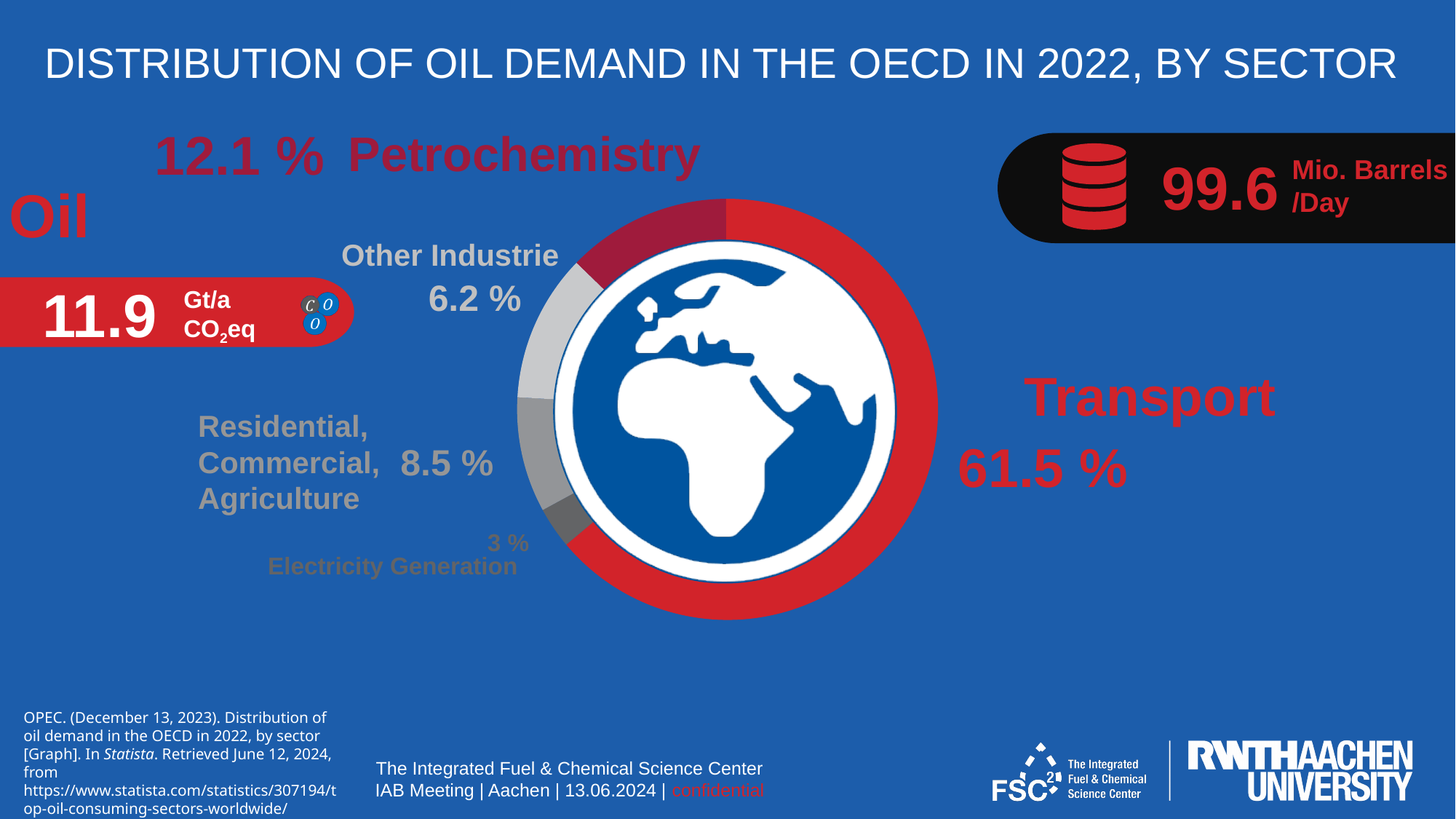
What share is shown for Residential, Commercial, Agriculture? 8.5 % What is the difference in percentage points between the Transport and Petrochemistry shares? 49.4 Which has a larger share: Other Industrie or Residential, Commercial, Agriculture? Residential, Commercial, Agriculture Which sector has the largest share of oil demand? Transport How many sectors are labelled with a percentage on the chart? 5 What share of OECD oil demand in 2022 does the Transport sector account for? 61.5 % What is the title of the slide? DISTRIBUTION OF OIL DEMAND IN THE OECD IN 2022, BY SECTOR What is the share for Other Industrie? 6.2 % What percentage of oil demand goes to Electricity Generation? 3 % What percentage of oil demand is attributed to Petrochemistry? 12.1 % Which labelled sector has the smallest share of oil demand? Electricity Generation What kind of chart is used to show the distribution of oil demand? Pie chart (donut)